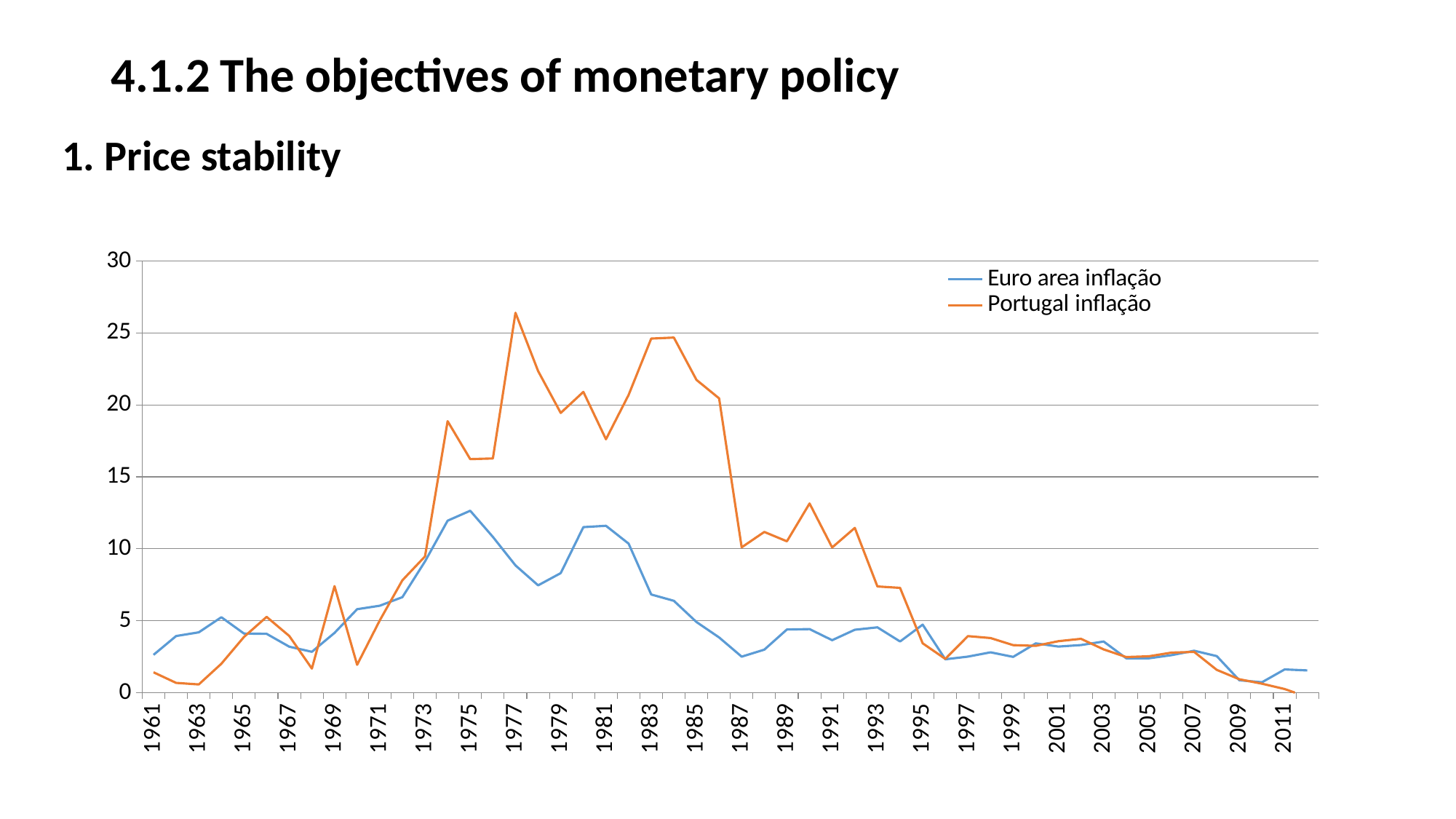
Is the value for Euro area inflação in 1987 greater or less than 5? less In which year does Portugal inflação reach its highest value? 1977 In which year does Euro area inflação reach its highest value? 1975 From 1987 to 2011, does Portugal inflação generally rise or fall? fall Is the value for Portugal inflação in 1977 greater or less than 25? greater Which series reaches the highest value on the chart? Portugal inflação In 1985, which series has the higher value, Euro area inflação or Portugal inflação? Portugal inflação What kind of chart is shown on the slide? line chart Is the value for Euro area inflação in 1975 greater or less than 10? greater How many series does the legend list? 2 In 1963, which series has the higher value, Euro area inflação or Portugal inflação? Euro area inflação What are the two series named in the legend? Euro area inflação and Portugal inflação